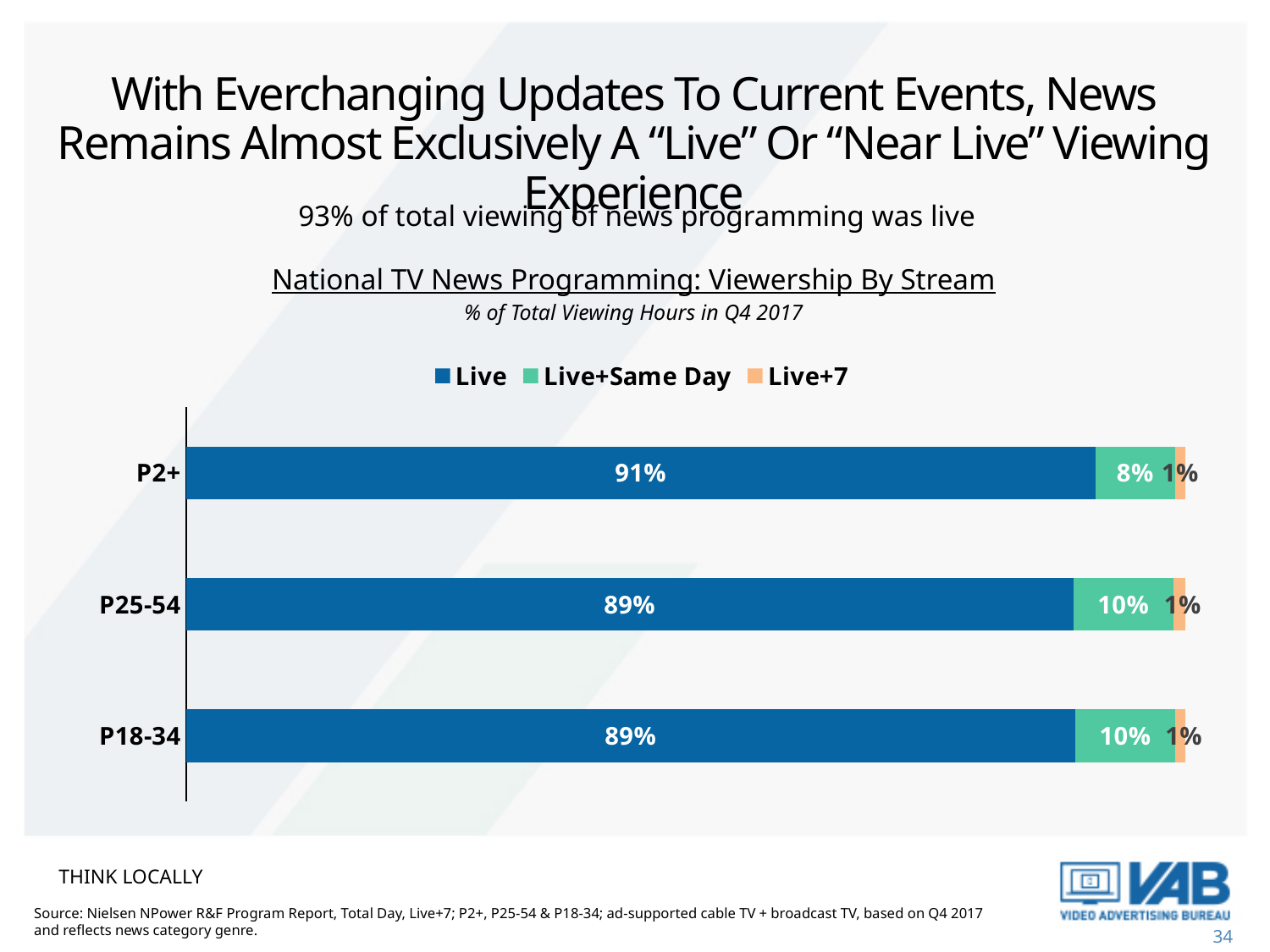
What is the Live value for P2+? 91% How many demographic categories are shown in the chart? 3 What is the Live value for P18-34? 89% How many series does the legend list? 3 Is the Live+Same Day value larger for P2+ or for P18-34? P18-34 Which demographic has the highest Live value? P2+ What kind of chart is shown on the slide? Stacked bar chart What is the title of the chart? National TV News Programming: Viewership By Stream What is the difference between the Live values for P2+ and P25-54? 2% What is the Live+Same Day value for P25-54? 10% What is the Live+7 value for P18-34? 1% Which demographic has the lowest Live+Same Day value? P2+